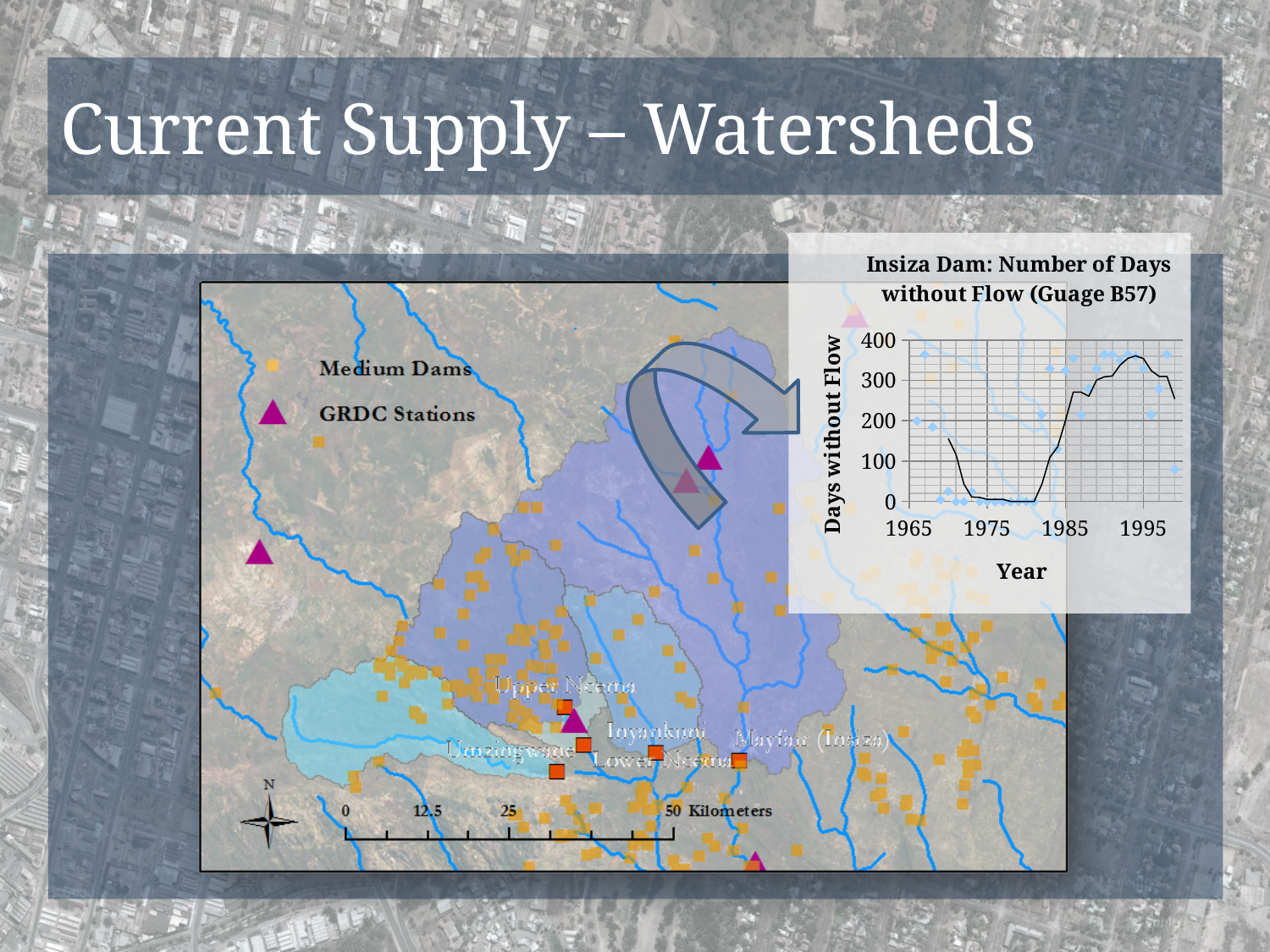
On the Insiza Dam chart, is the number of days without flow around 1975 greater or less than 100? less What is the label of the horizontal axis on the Insiza Dam chart? Year What is the title of the chart on the slide? Insiza Dam: Number of Days without Flow (Guage B57) On the Insiza Dam chart, does the trend line rise or fall between 1982 and 1992? rises On the Insiza Dam chart, what is the highest value shown on the vertical axis? 400 On the Insiza Dam chart, does the trend line rise or fall between 1970 and 1975? falls On the Insiza Dam chart, is the number of days without flow around 1978 greater or less than 200? less On the Insiza Dam chart, is the number of days without flow around 1993 greater or less than 300? greater On the Insiza Dam chart, which period has more days without flow: around 1977 or around 1990? around 1990 What kind of chart is the Insiza Dam chart? scatter chart with a trend line